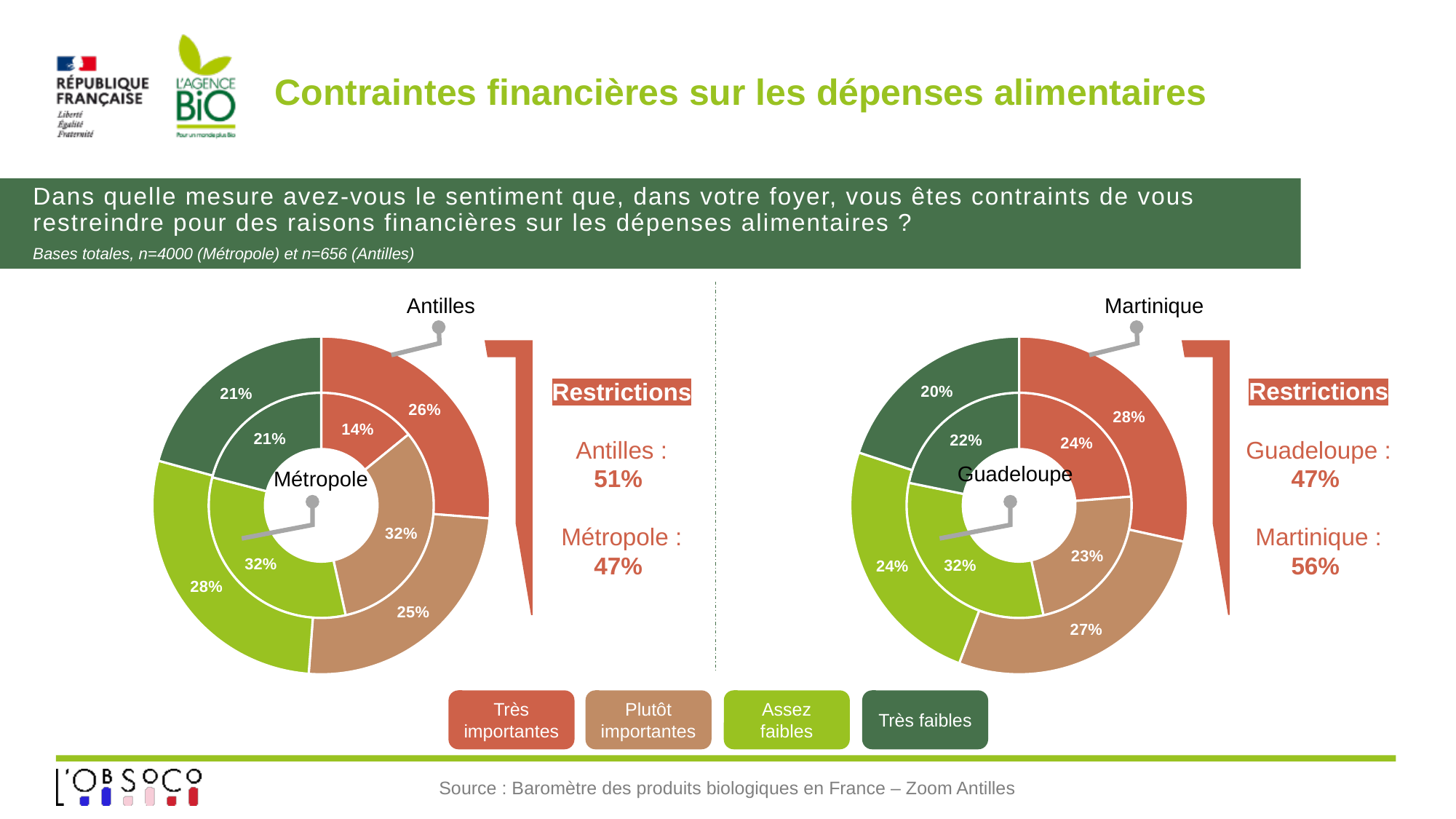
What is the total 'Restrictions' figure shown for Martinique? 56% In the right chart, what percentage of Martinique respondents report 'Plutôt importantes' restrictions? 27% In the right chart, which category has the smallest share for Martinique? Très faibles In the left chart, what is the difference between the 'Très importantes' share for Antilles and for Métropole? 12 percentage points What is the total 'Restrictions' figure shown for Métropole? 47% How many categories does the legend list? 4 What type of chart is used on this slide? Donut (pie) chart In the left chart, which category has the largest share for Antilles? Assez faibles In the right chart, what percentage of Guadeloupe respondents report 'Assez faibles' restrictions? 32% In the right chart, which has a larger 'Très importantes' share, Martinique or Guadeloupe? Martinique In the left chart, what percentage of Métropole respondents report 'Très importantes' restrictions? 14% In the left chart, what percentage of Antilles respondents report 'Très importantes' financial restrictions? 26%